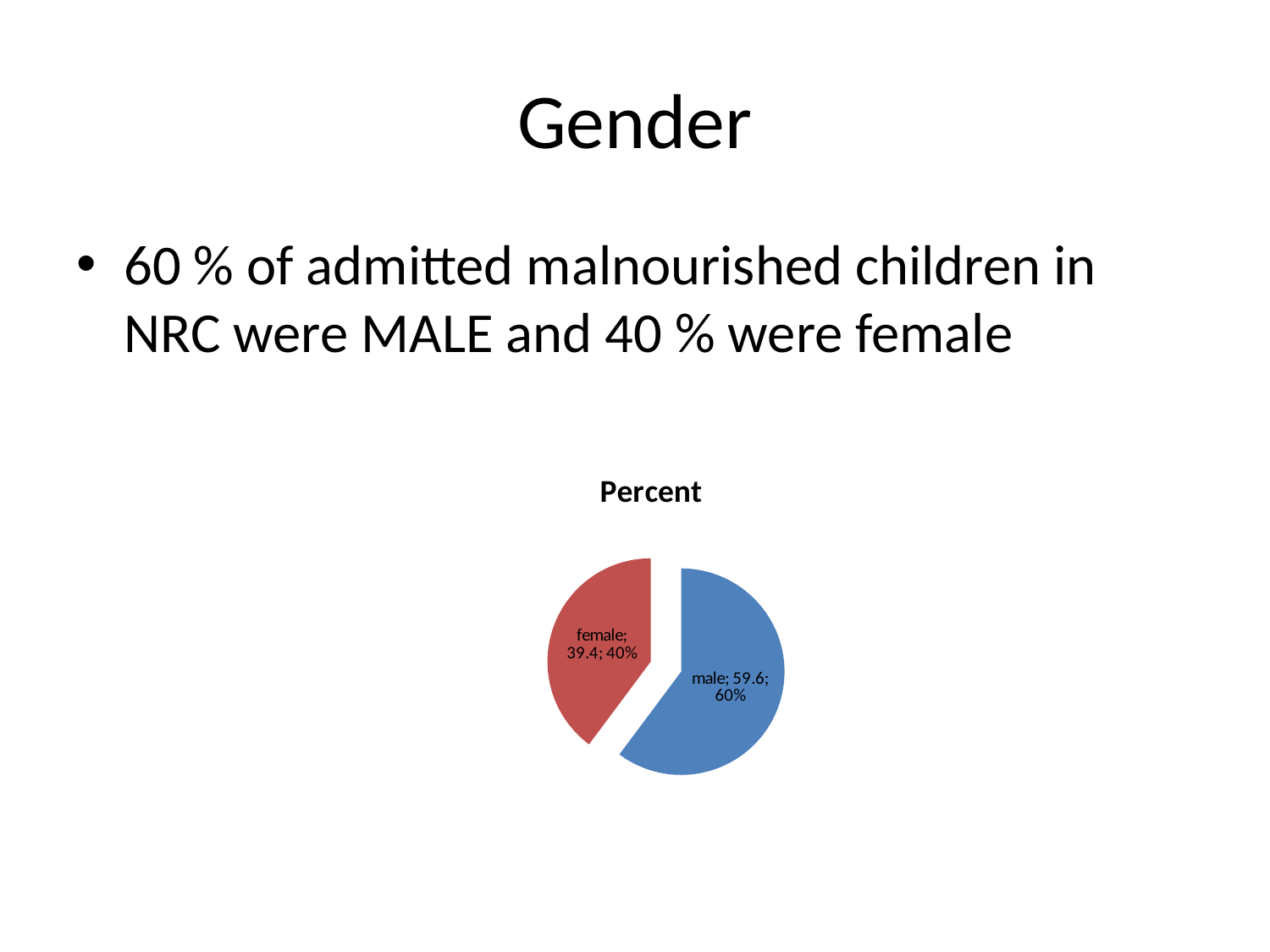
What is the difference between the male and female values? 20.2 What is the title of the chart? Percent Which is larger, the male value or the female value? male How many slices does the pie chart have? 2 What is the value for male in the pie chart? 59.6 Which category has the largest slice in the pie chart? male What is the value for female in the pie chart? 39.4 Which category has the smallest slice in the pie chart? female What type of chart is shown on the slide? pie chart What share of the pie does the male slice represent? 60% What colour is the female slice in the pie chart? red What share of the pie does the female slice represent? 40%